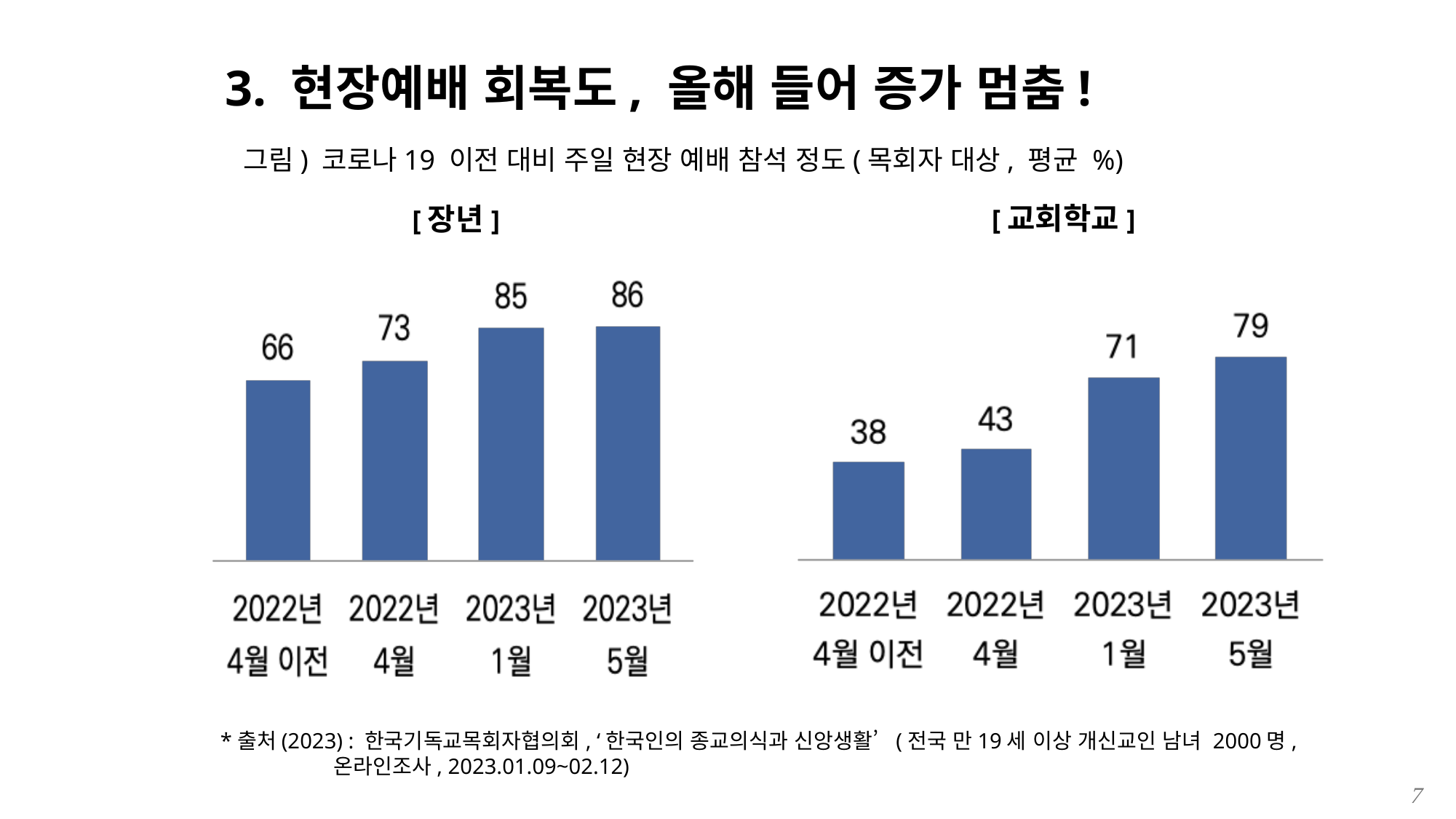
In the [교회학교] chart, what is the value for 2022년 4월 이전? 38 In the [장년] chart, what is the difference between the values for 2023년 1월 and 2022년 4월? 12 What colour are the bars in the [장년] chart? Blue In the [장년] chart, what is the value for 2023년 5월? 86 How many bars does the [장년] chart have? 4 Which is larger: the value for 2022년 4월 in the [장년] chart or the value for 2023년 5월 in the [교회학교] chart? 2023년 5월 in the [교회학교] chart In the [교회학교] chart, what is the value for 2023년 1월? 71 In the [교회학교] chart, do the values rise or fall from left to right? Rise What kind of chart is the [교회학교] chart? Bar chart In the [장년] chart, which category has the lowest value? 2022년 4월 이전 In the [교회학교] chart, which category has the highest value? 2023년 5월 In the [교회학교] chart, what is the difference between the values for 2023년 5월 and 2022년 4월 이전? 41